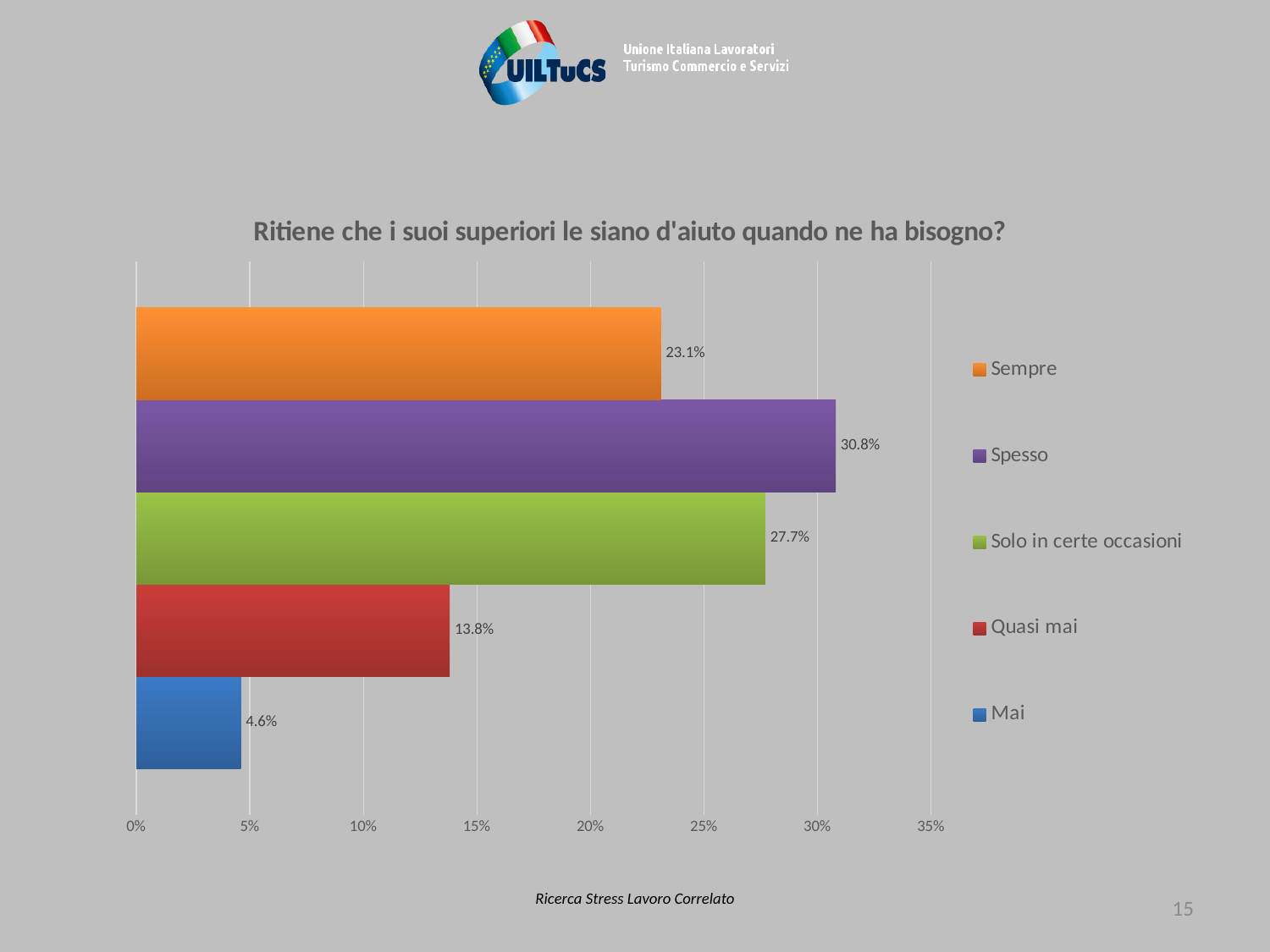
How many categories are shown in the chart? 5 Which category has the lowest value? Mai What is the value for Spesso? 30.8% Which is larger, the value for Sempre or the value for Quasi mai? Sempre What kind of chart is shown on the slide? bar chart What is the value for Quasi mai? 13.8% What is the title of the chart? Ritiene che i suoi superiori le siano d'aiuto quando ne ha bisogno? Is the value for Solo in certe occasioni greater or less than 25%? greater What is the difference between the values for Spesso and Solo in certe occasioni? 3.1% What is the value for Mai? 4.6% Which category has the highest value? Spesso What is the value for Sempre? 23.1%